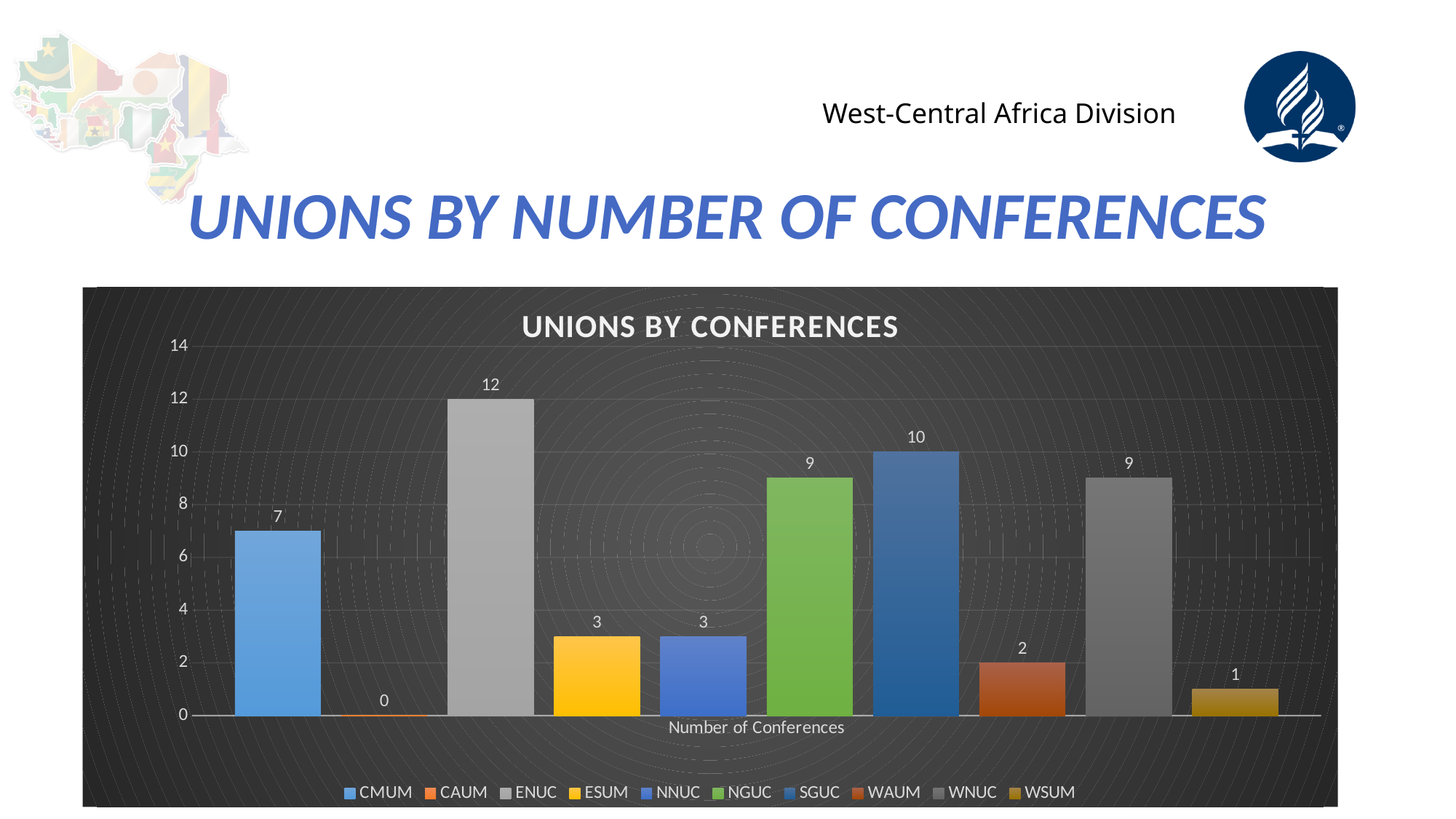
What is the number of conferences for ENUC? 12 Which union has the highest number of conferences? ENUC What kind of chart is shown on the slide? Bar chart Which has more conferences, CMUM or WNUC? WNUC What is the title of the chart? UNIONS BY CONFERENCES Is the value for NGUC greater or less than 8? greater What is the number of conferences for SGUC? 10 Which union has the lowest number of conferences? CAUM What is the number of conferences for CAUM? 0 How many unions are listed in the legend? 10 What is the difference between the number of conferences for ENUC and SGUC? 2 What is the difference between the number of conferences for WAUM and WSUM? 1